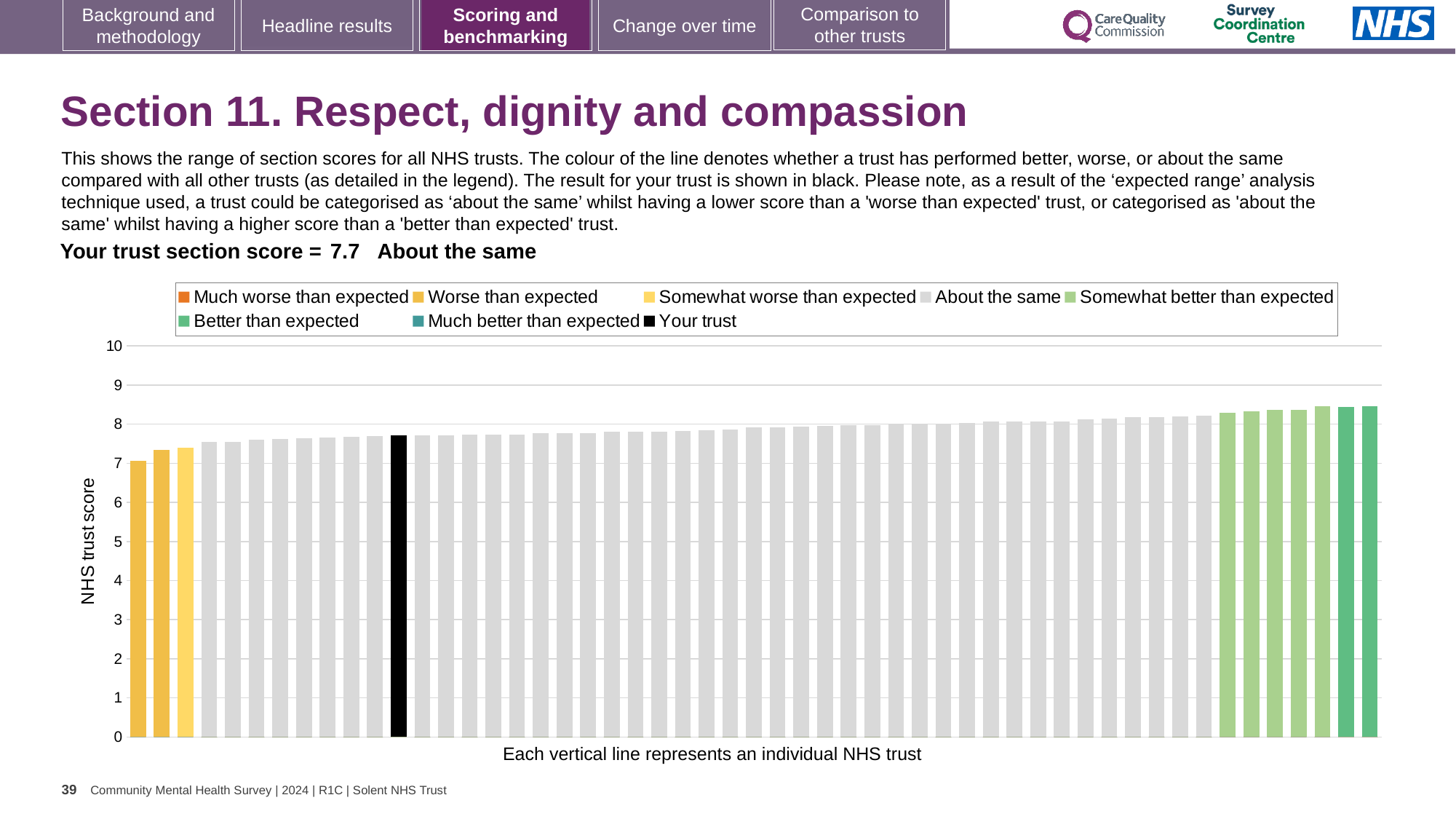
What is the section score for your trust shown on the slide? 7.7 Is the value of the rightmost bar greater or less than 8? greater What is the label on the vertical axis of the chart? NHS trust score Do the bar values rise or fall from left to right along the x axis? rise What kind of chart is shown on the slide? bar chart Is your trust's score (the black bar) greater or less than 7? greater What is the highest value shown on the vertical axis? 10 Which is larger: the value of the rightmost bar or the value of the leftmost bar? the rightmost bar Is the value of the leftmost bar greater or less than 8? less What colour is the bar representing your trust? black How many entries does the chart legend list? 8 How is your trust's score categorised compared with other trusts? About the same